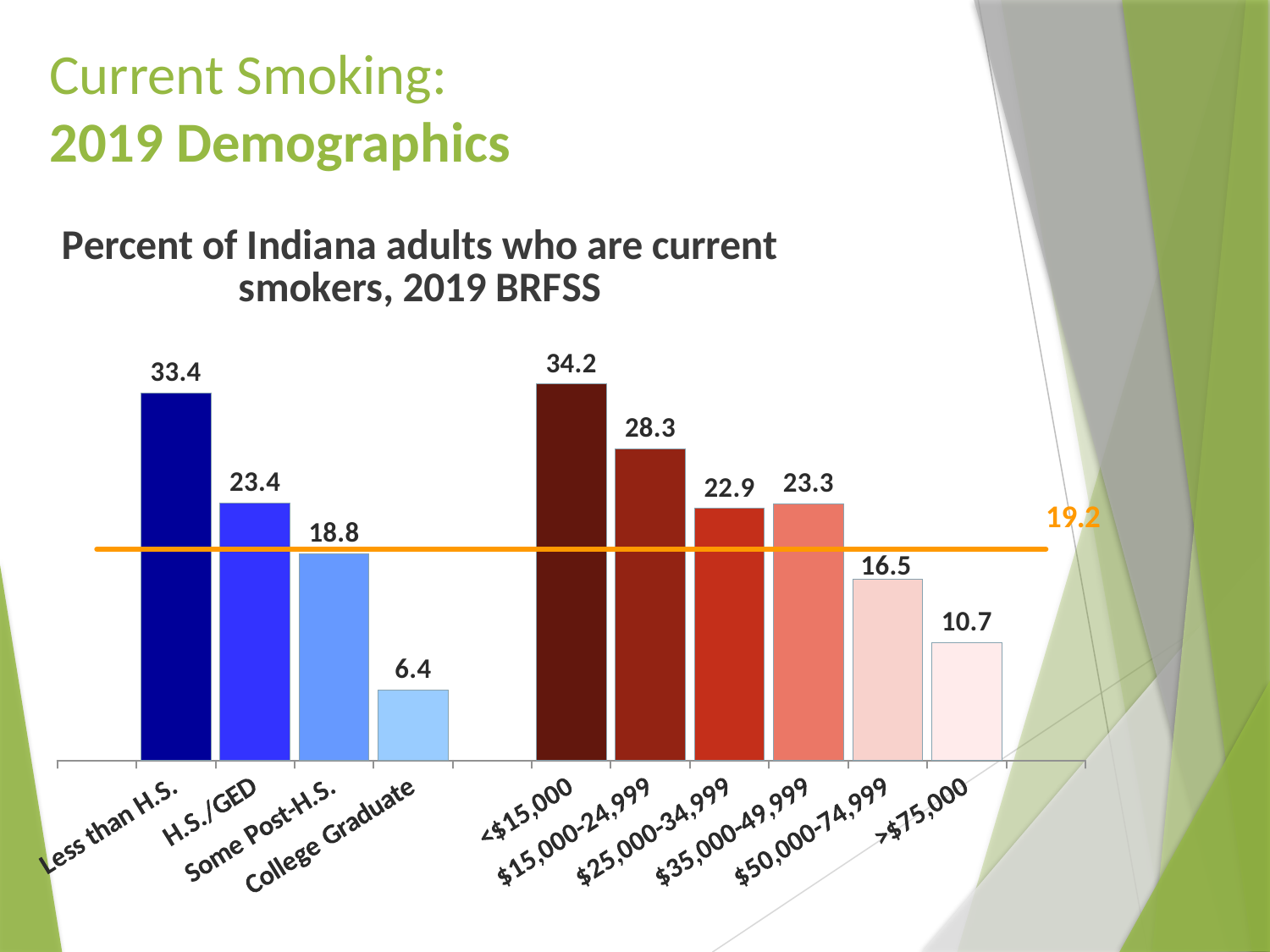
What kind of chart is shown on the slide? Bar chart What is the value for the >$75,000 income group? 10.7 What is the value for College Graduate? 6.4 What is the difference between the values for <$15,000 and >$75,000? 23.5 What is the value for the $15,000-24,999 income group? 28.3 What value is marked by the orange horizontal line on the chart? 19.2 Which is larger, the value for H.S./GED or the value for $50,000-74,999? H.S./GED How many bars are plotted on the chart? 10 What is the value for Less than H.S.? 33.4 Which category has the highest value on the chart? <$15,000 Which category has the lowest value on the chart? College Graduate What is the difference between the values for Less than H.S. and College Graduate? 27.0